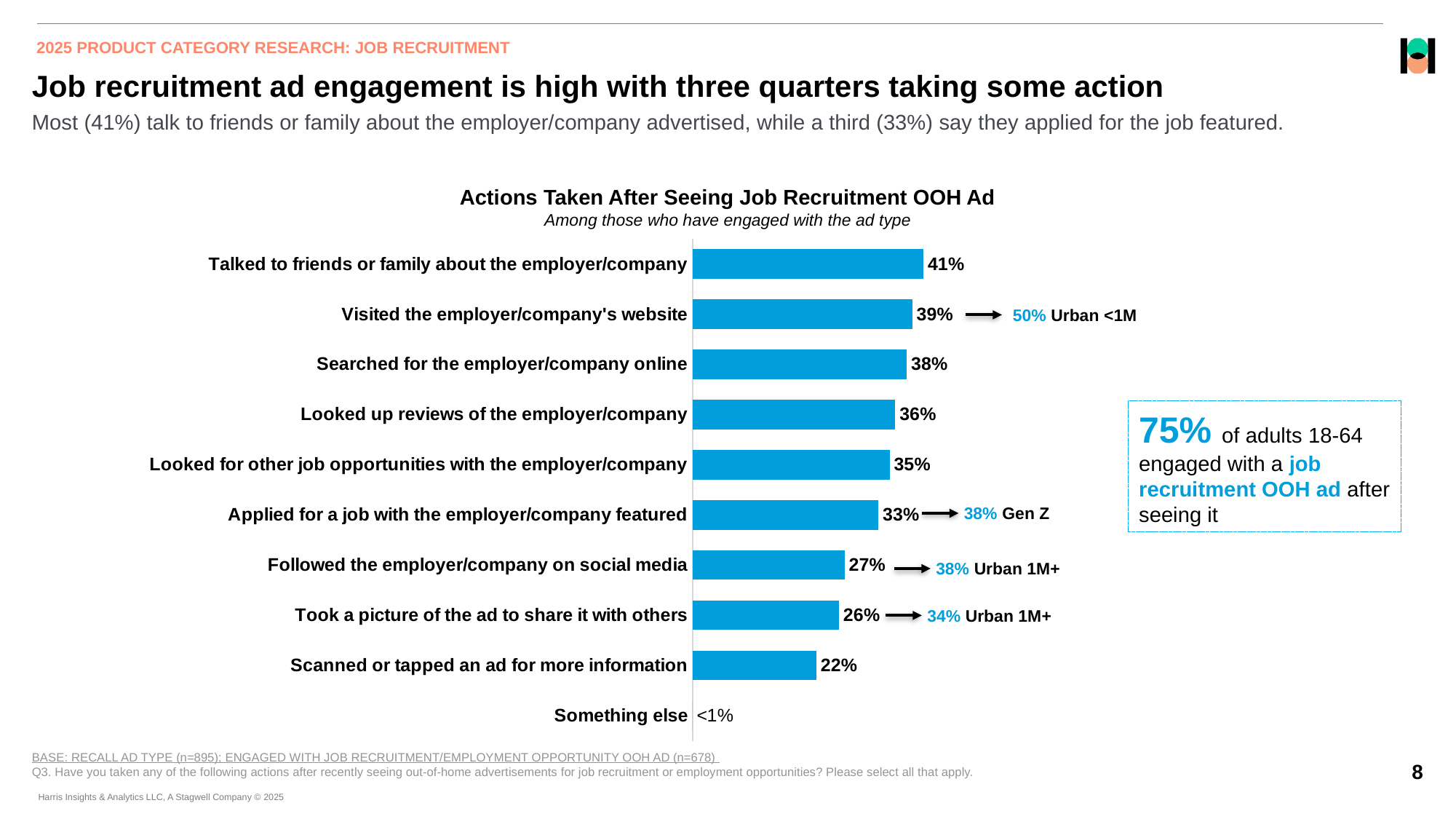
What is the difference between the percentage who visited the employer/company's website and the percentage who followed the employer/company on social media? 12% What is the title of the chart? Actions Taken After Seeing Job Recruitment OOH Ad What percentage scanned or tapped an ad for more information? 22% How many action categories are shown in the chart? 10 What percentage of Gen Z applied for a job with the employer/company featured, according to the callout? 38% Which is larger: the percentage who looked up reviews of the employer/company or the percentage who took a picture of the ad to share it with others? Looked up reviews of the employer/company What percentage applied for a job with the employer/company featured? 33% Which action has the highest percentage in the chart? Talked to friends or family about the employer/company Which action has the lowest percentage in the chart? Something else What percentage talked to friends or family about the employer/company after seeing a job recruitment OOH ad? 41% What type of chart is used to show the actions taken after seeing a job recruitment OOH ad? Bar chart What percentage of Urban <1M respondents visited the employer/company's website, according to the callout? 50%